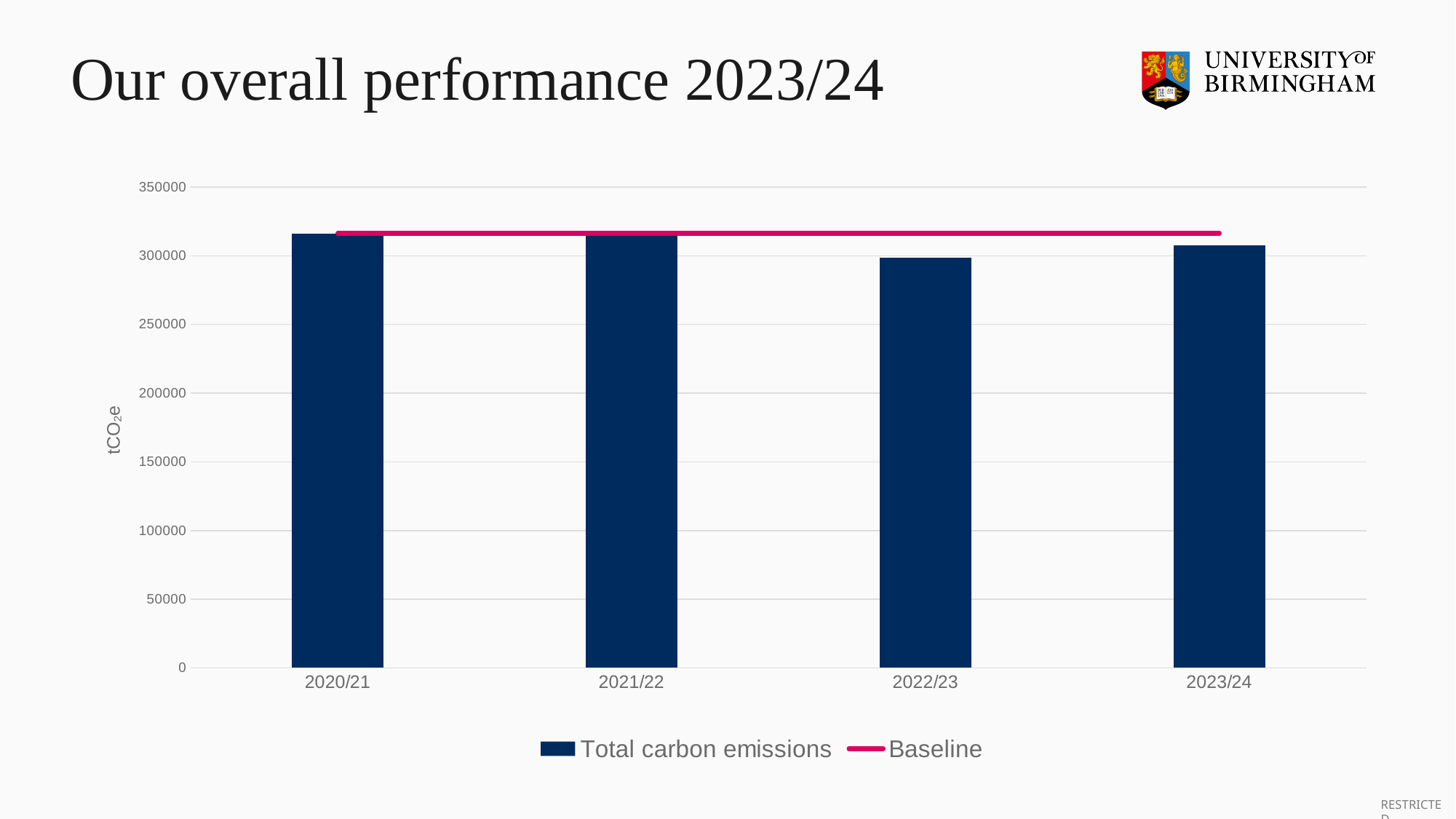
What is the label on the y axis of the chart? tCO₂e Is the Baseline line greater or less than 300000? greater What are the two entries in the chart's legend? Total carbon emissions and Baseline Which is larger, the total carbon emissions for 2022/23 or for 2023/24? 2023/24 Is the value for 2020/21 greater or less than 350000? less Which is larger, the total carbon emissions for 2020/21 or for 2022/23? 2020/21 How many series does the chart's legend list? 2 What kind of chart is shown on the slide? Combination bar and line chart How many years (categories) are shown on the x axis of the chart? 4 Is the value for 2022/23 greater or less than 250000? greater Which year has the lowest total carbon emissions? 2022/23